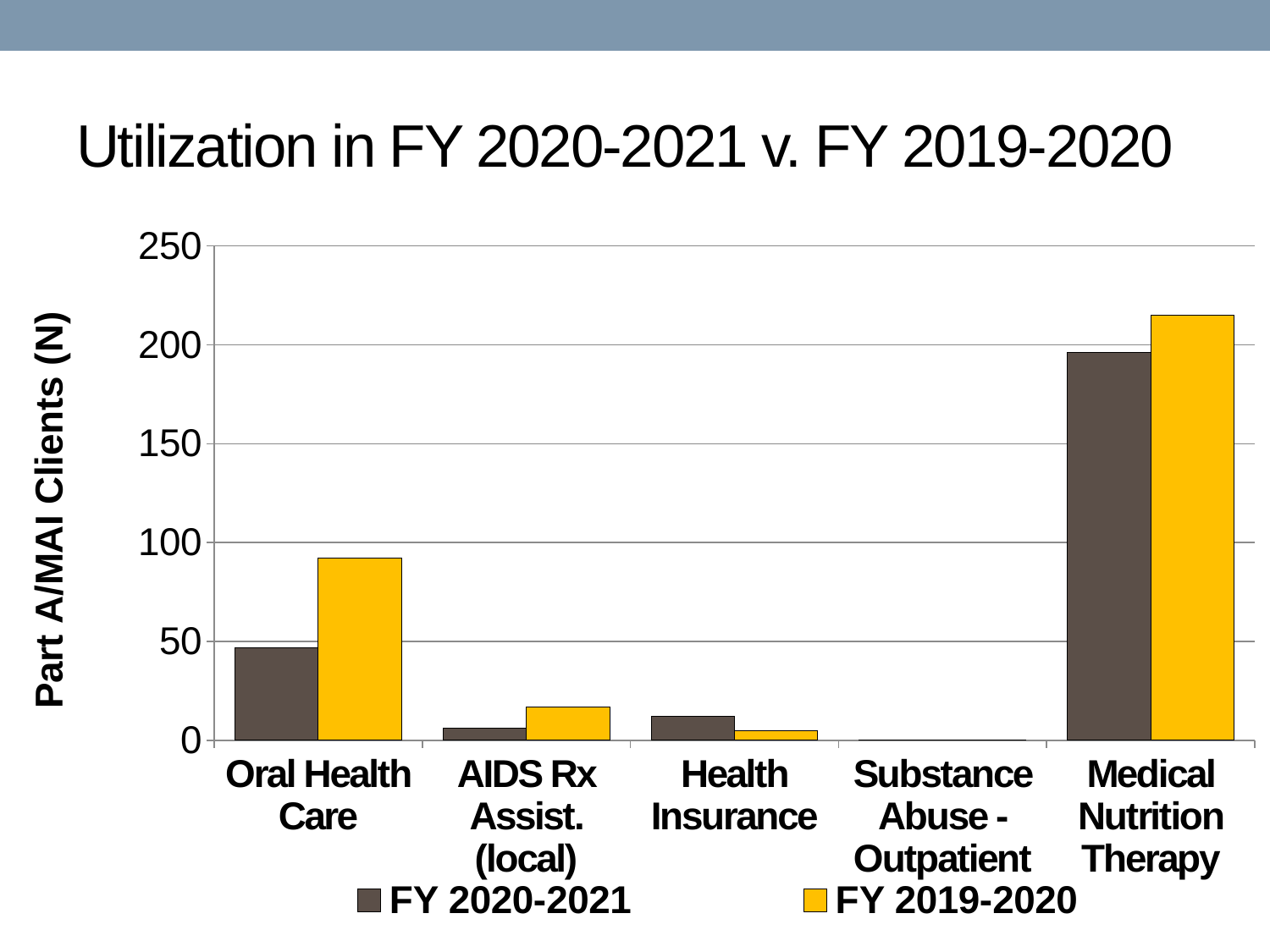
Is the FY 2019-2020 value for Oral Health Care greater or less than 50? greater For Health Insurance, which fiscal year has the larger value, FY 2020-2021 or FY 2019-2020? FY 2020-2021 How many series does the legend list? 2 Which category has the highest value for FY 2019-2020? Medical Nutrition Therapy Which category has the lowest value for FY 2020-2021? Substance Abuse - Outpatient For Oral Health Care, which fiscal year has the larger value, FY 2020-2021 or FY 2019-2020? FY 2019-2020 Which category has the highest value for FY 2020-2021? Medical Nutrition Therapy How many service categories are shown on the x axis? 5 Is the FY 2020-2021 value for Medical Nutrition Therapy greater or less than 150? greater What kind of chart is shown on the slide? bar chart Is the FY 2019-2020 value for Medical Nutrition Therapy greater or less than 200? greater What is the title of the y axis? Part A/MAI Clients (N)